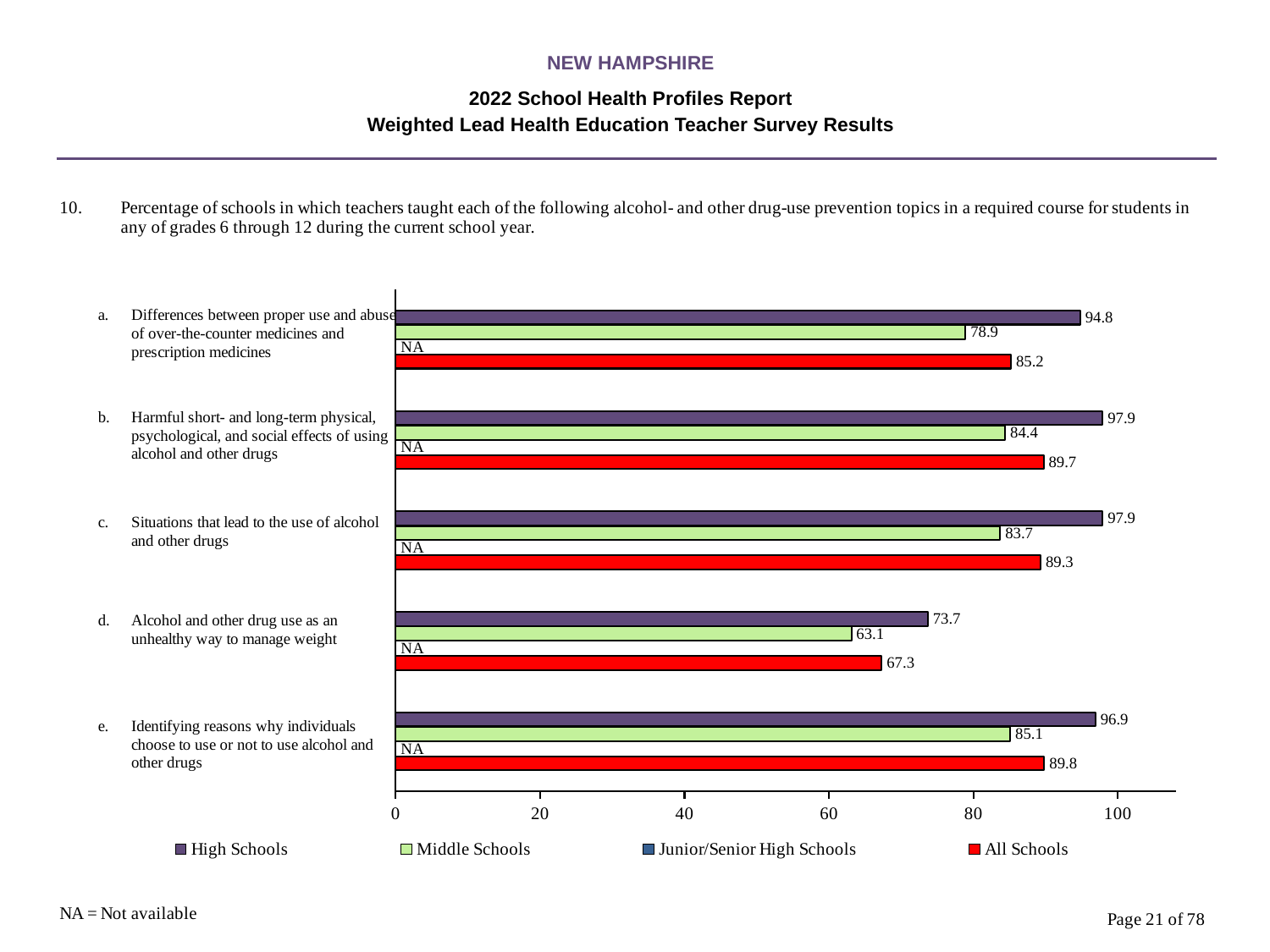
What is the High Schools value for topic d, alcohol and other drug use as an unhealthy way to manage weight? 73.7 What is the All Schools value for topic e, identifying reasons why individuals choose to use or not to use alcohol and other drugs? 89.8 How many series does the legend list? 4 Which topic has the lowest All Schools value? d. Alcohol and other drug use as an unhealthy way to manage weight Is the Middle Schools value for topic d greater or less than 80? less How many topics are listed on the chart? 5 For topic c, situations that lead to the use of alcohol and other drugs, which is larger: the High Schools value or the All Schools value? High Schools What is the Middle Schools value for topic a, differences between proper use and abuse of over-the-counter medicines and prescription medicines? 78.9 What is the difference between the High Schools and Middle Schools values for topic b, harmful short- and long-term effects of using alcohol and other drugs? 13.5 What kind of chart is shown on the slide? bar chart Which topic has the highest Middle Schools value? e. Identifying reasons why individuals choose to use or not to use alcohol and other drugs What value is shown for the Junior/Senior High Schools series for each topic? NA